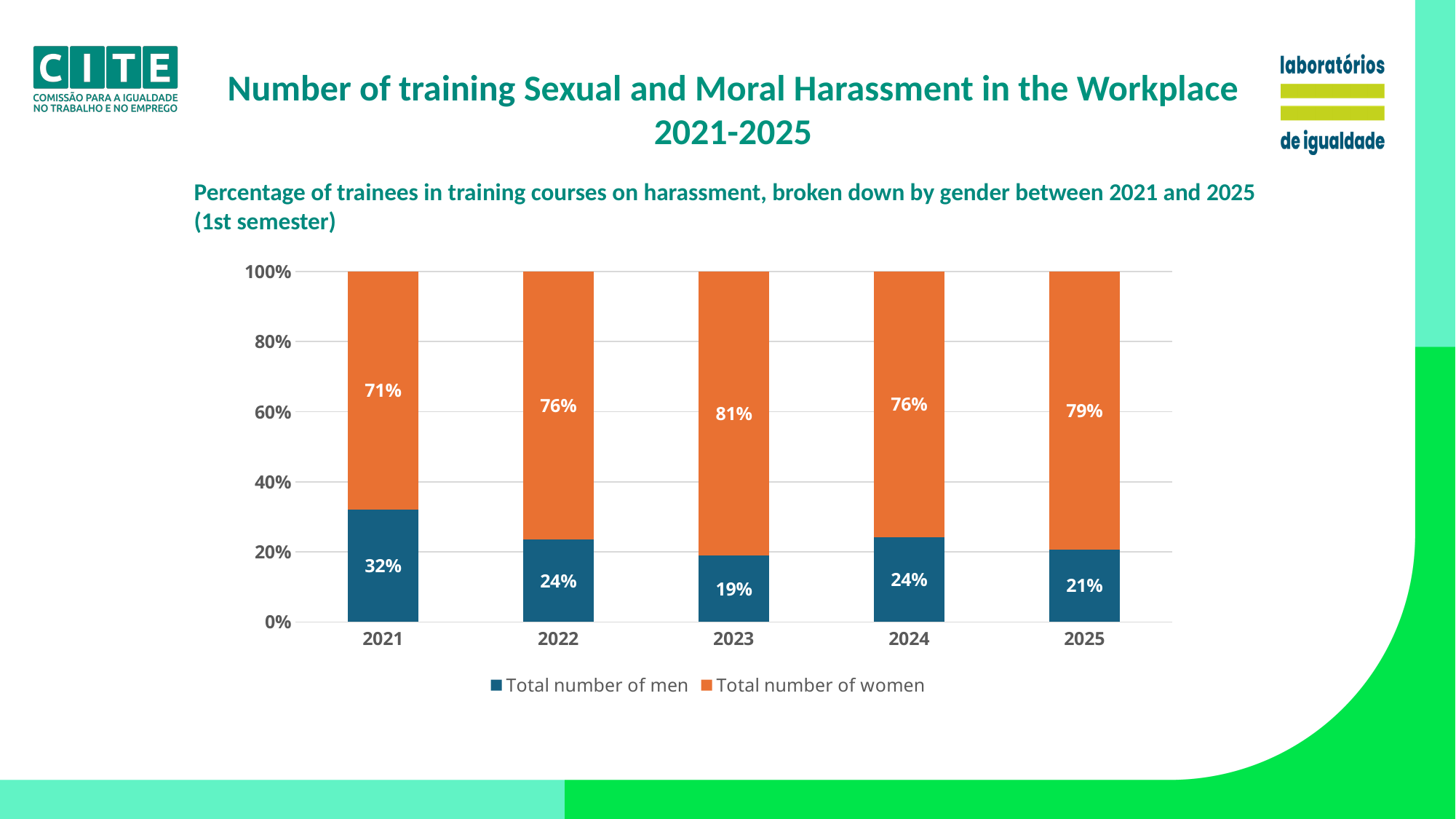
In which year was the share of men among trainees highest? 2021 What percentage of trainees were women in 2023? 81% How many years are shown on the x axis of the chart? 5 In which year was the share of men among trainees lowest? 2023 How many series does the legend list? 2 What kind of chart is shown on the slide? Stacked bar chart What is the difference between the share of women and the share of men in 2022? 52 percentage points Which colour represents the 'Total number of women' series? Orange What percentage of trainees were women in 2025? 79% What percentage of trainees were men in 2021? 32% Which is larger: the share of men in 2024 or the share of men in 2025? 2024 In which year was the share of women among trainees highest? 2023